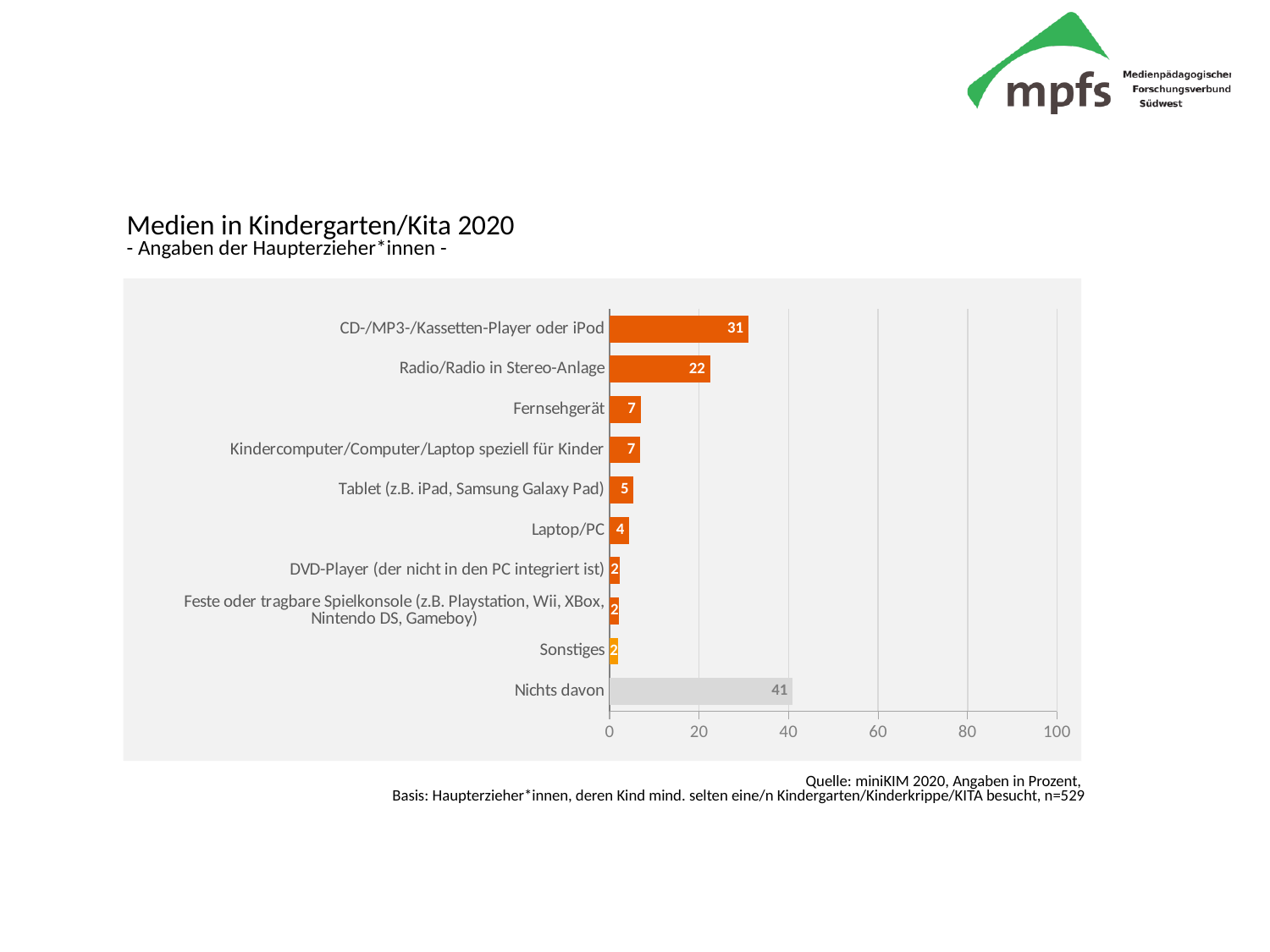
What is the value for Radio/Radio in Stereo-Anlage? 22 What is the value for CD-/MP3-/Kassetten-Player oder iPod? 31 Is the value for Nichts davon greater or less than 40? greater How many categories are shown in the chart? 10 What kind of chart is shown on the slide? bar chart What is the title of the chart? Medien in Kindergarten/Kita 2020 Which is larger, the value for Fernsehgerät or the value for Laptop/PC? Fernsehgerät What is the value for Tablet (z.B. iPad, Samsung Galaxy Pad)? 5 What is the value for Laptop/PC? 4 What is the difference between the values for CD-/MP3-/Kassetten-Player oder iPod and Radio/Radio in Stereo-Anlage? 9 Which category has the highest value? Nichts davon What is the value for Nichts davon? 41